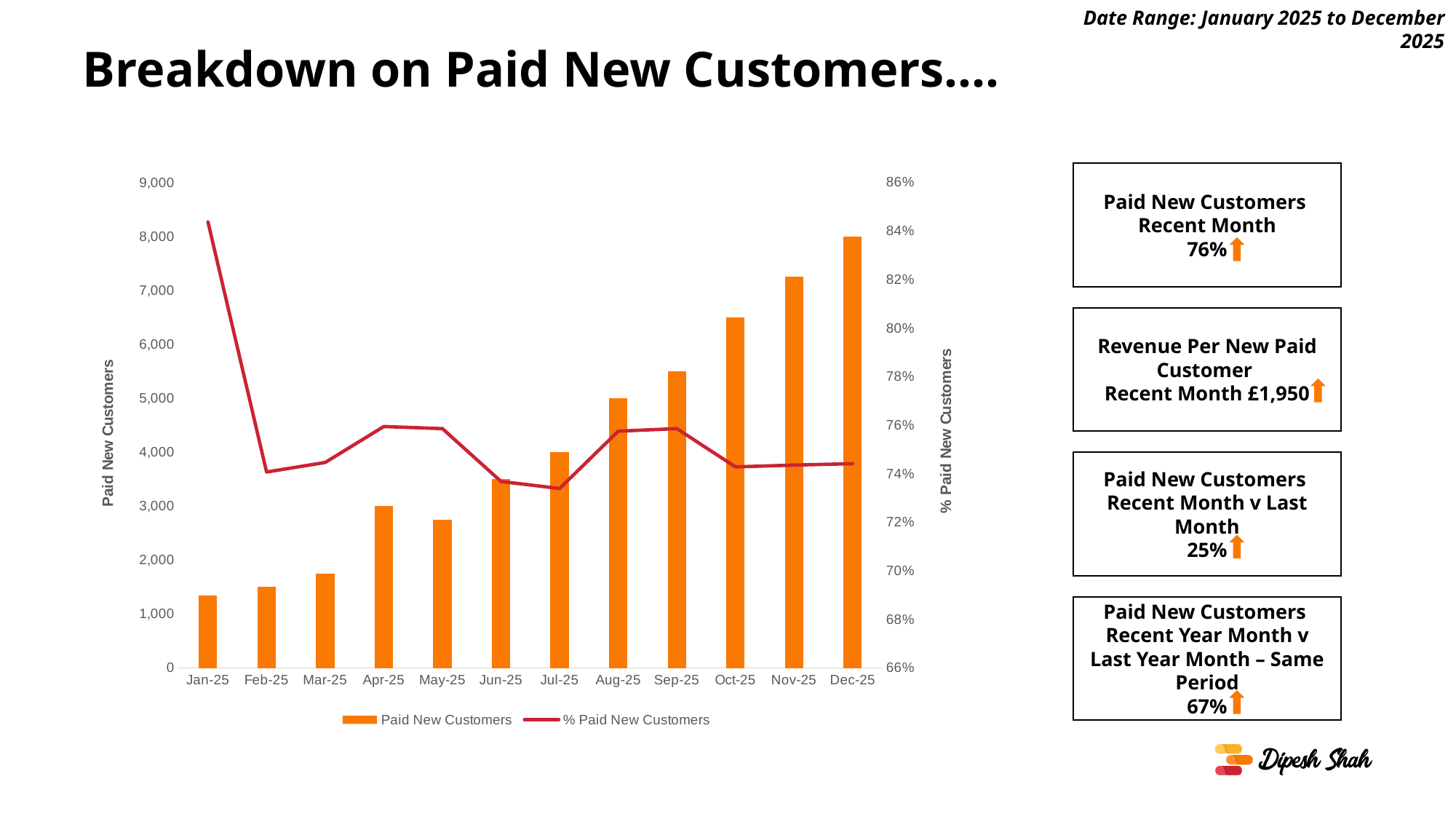
Which month has the lowest number of Paid New Customers? Jan-25 What is the label of the right-hand vertical axis? % Paid New Customers What kind of chart is shown on the slide? Combined bar and line chart Do the Paid New Customers bars generally rise or fall from Jun-25 to Dec-25? Rise Which month has the highest number of Paid New Customers? Dec-25 Is the % Paid New Customers value for Jan-25 greater or less than 84%? greater How many series does the legend list? 2 Which month has more Paid New Customers, Apr-25 or May-25? Apr-25 How many months are plotted along the x axis? 12 In which month is the % Paid New Customers line at its highest? Jan-25 Is the value for Paid New Customers in Mar-25 greater or less than 2,000? less Is the value for Paid New Customers in Oct-25 greater or less than 6,000? greater